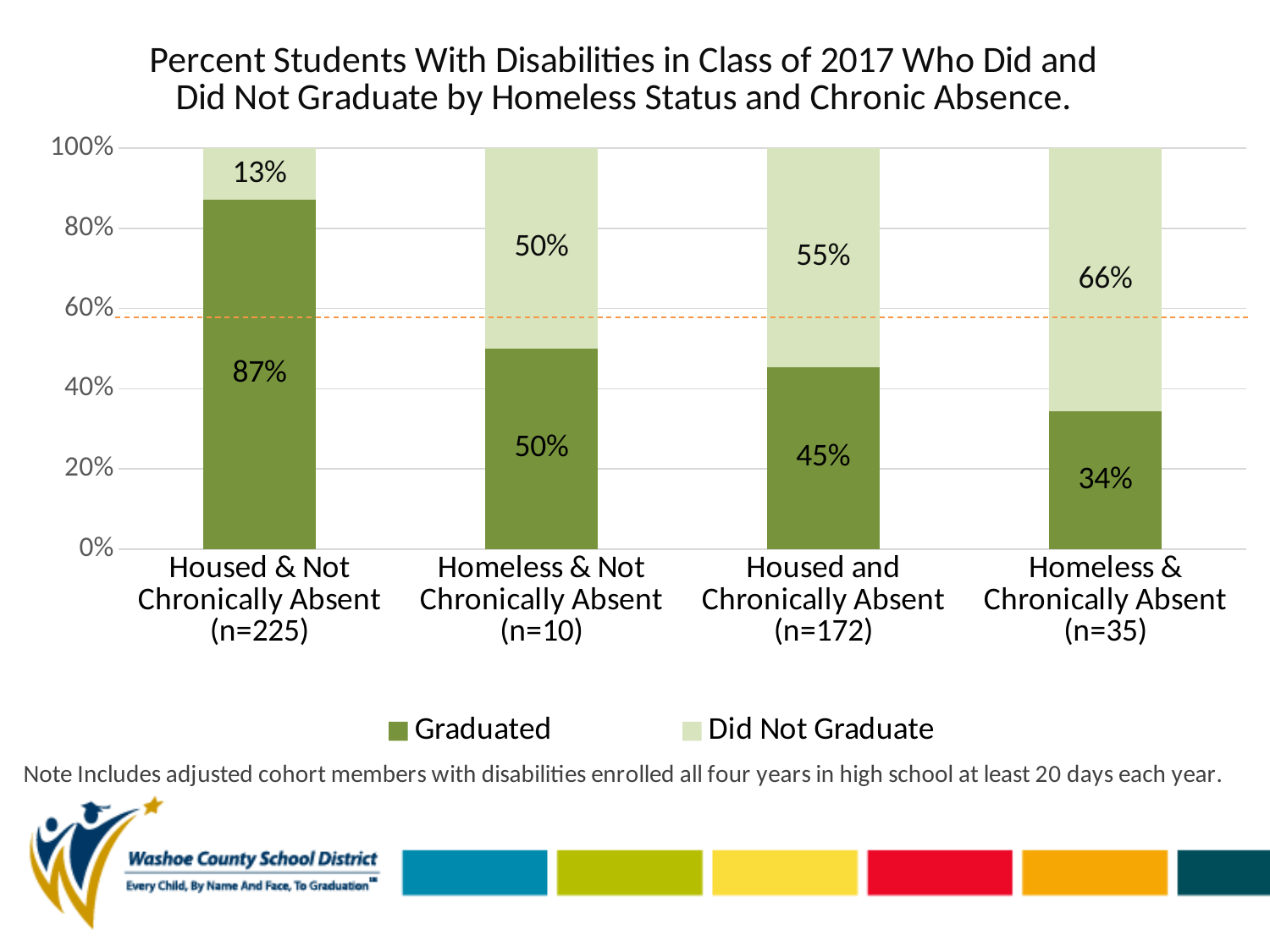
What percent of Housed & Not Chronically Absent students (n=225) graduated? 87% Is the Graduated value for Homeless & Chronically Absent greater or less than 40%? less Do the Graduated percentages rise or fall from left to right across the groups? Fall Which group has the highest Graduated percentage? Housed & Not Chronically Absent (n=225) What is the difference between the Graduated percentages for Housed & Not Chronically Absent and Homeless & Chronically Absent? 53% How many series does the legend list? 2 What percent of Homeless & Chronically Absent students (n=35) did not graduate? 66% What is the Graduated value for the Housed and Chronically Absent (n=172) group? 45% How many groups are shown on the x axis? 4 What kind of chart is shown? Stacked bar chart Which is larger: the Did Not Graduate value for Housed and Chronically Absent or for Homeless & Not Chronically Absent? Housed and Chronically Absent Which group has the lowest Graduated percentage? Homeless & Chronically Absent (n=35)